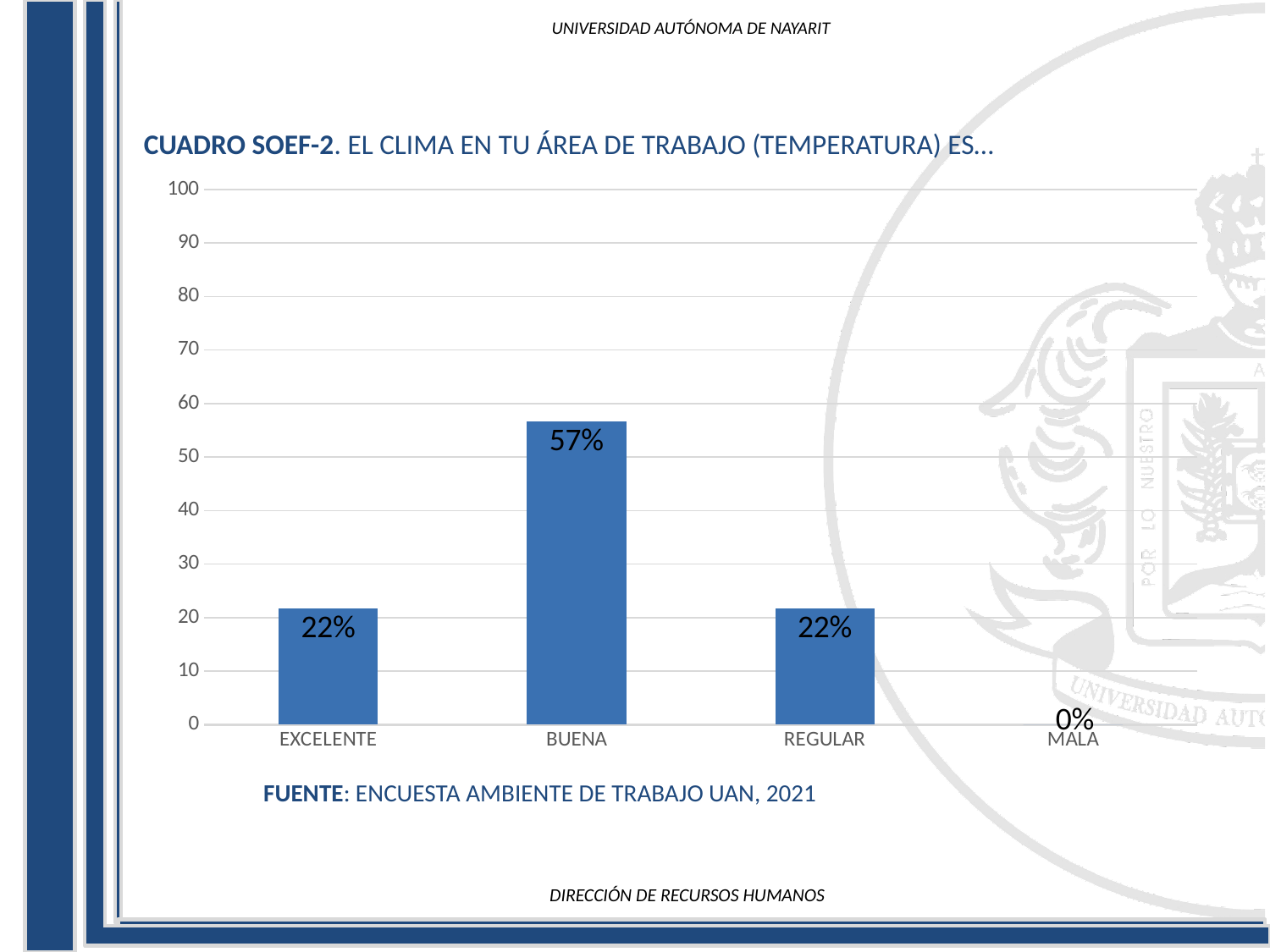
What is the title of the chart? CUADRO SOEF-2. EL CLIMA EN TU ÁREA DE TRABAJO (TEMPERATURA) ES… Which is larger, the value for BUENA or the value for EXCELENTE? BUENA What kind of chart is shown on the slide? bar chart What is the value for MALA? 0% What is the value for BUENA? 57% What is the difference between the values for BUENA and REGULAR? 35% Which category has the highest value? BUENA Which category has the lowest value? MALA How many categories are shown on the x axis? 4 What source is cited below the chart? ENCUESTA AMBIENTE DE TRABAJO UAN, 2021 What is the value for EXCELENTE? 22% Is the value for BUENA greater or less than 50? greater